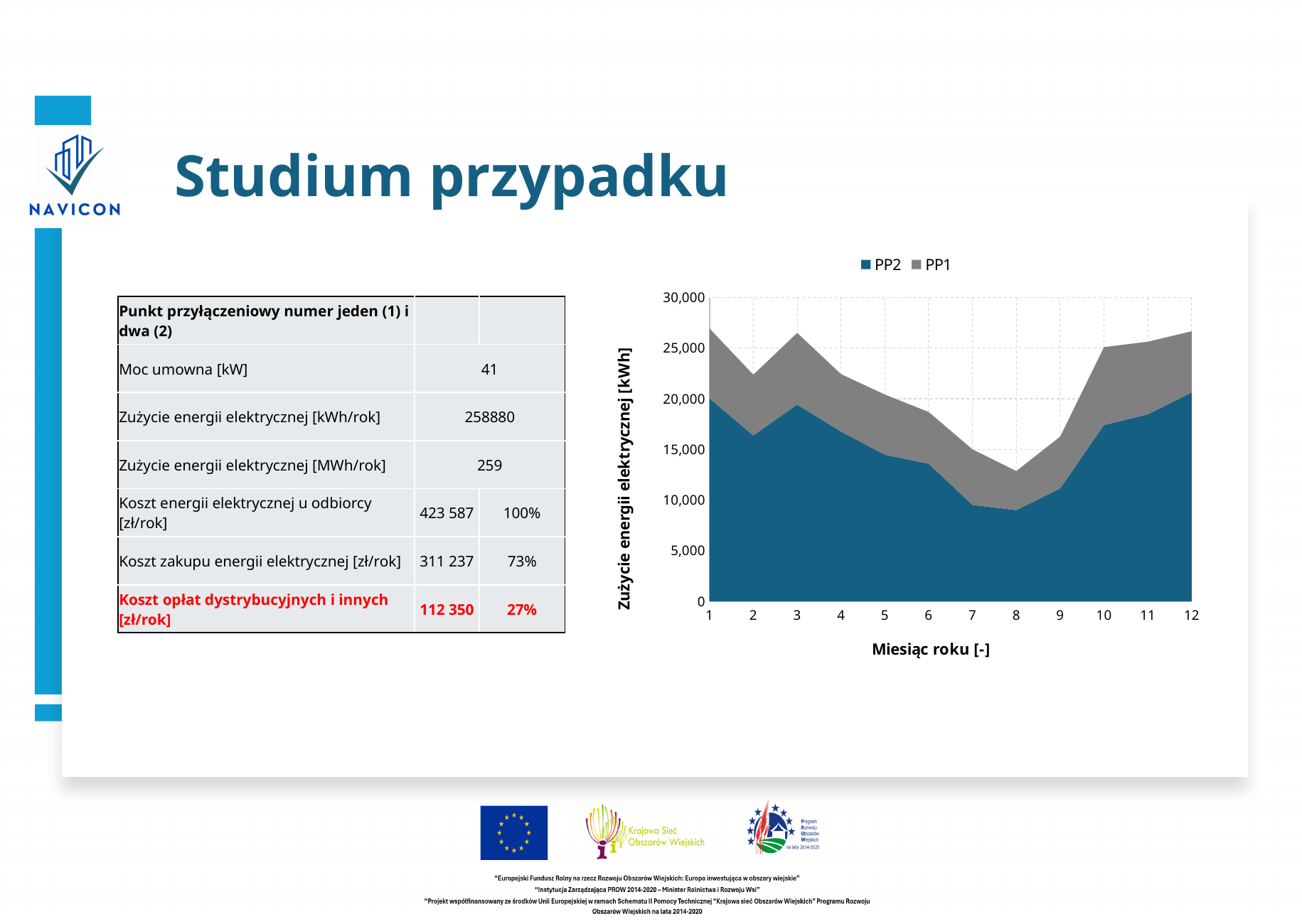
How many months are plotted along the x axis of the chart? 12 What kind of chart is shown on the slide? Stacked area chart Do the combined values rise or fall from month 3 to month 8? Fall How many series does the chart legend list? 2 Is the combined (PP2 plus PP1) value for month 8 greater or less than 15,000? less Which month has the larger PP2 value, month 1 or month 8? Month 1 What is the title of the chart's y axis? Zużycie energii elektrycznej [kWh] Is the combined (PP2 plus PP1) value for month 1 greater or less than 25,000? greater Which series are listed in the chart legend? PP2 and PP1 In which month is the combined (PP2 plus PP1) consumption lowest? 8 Is the PP2 value for month 8 greater or less than 10,000? less